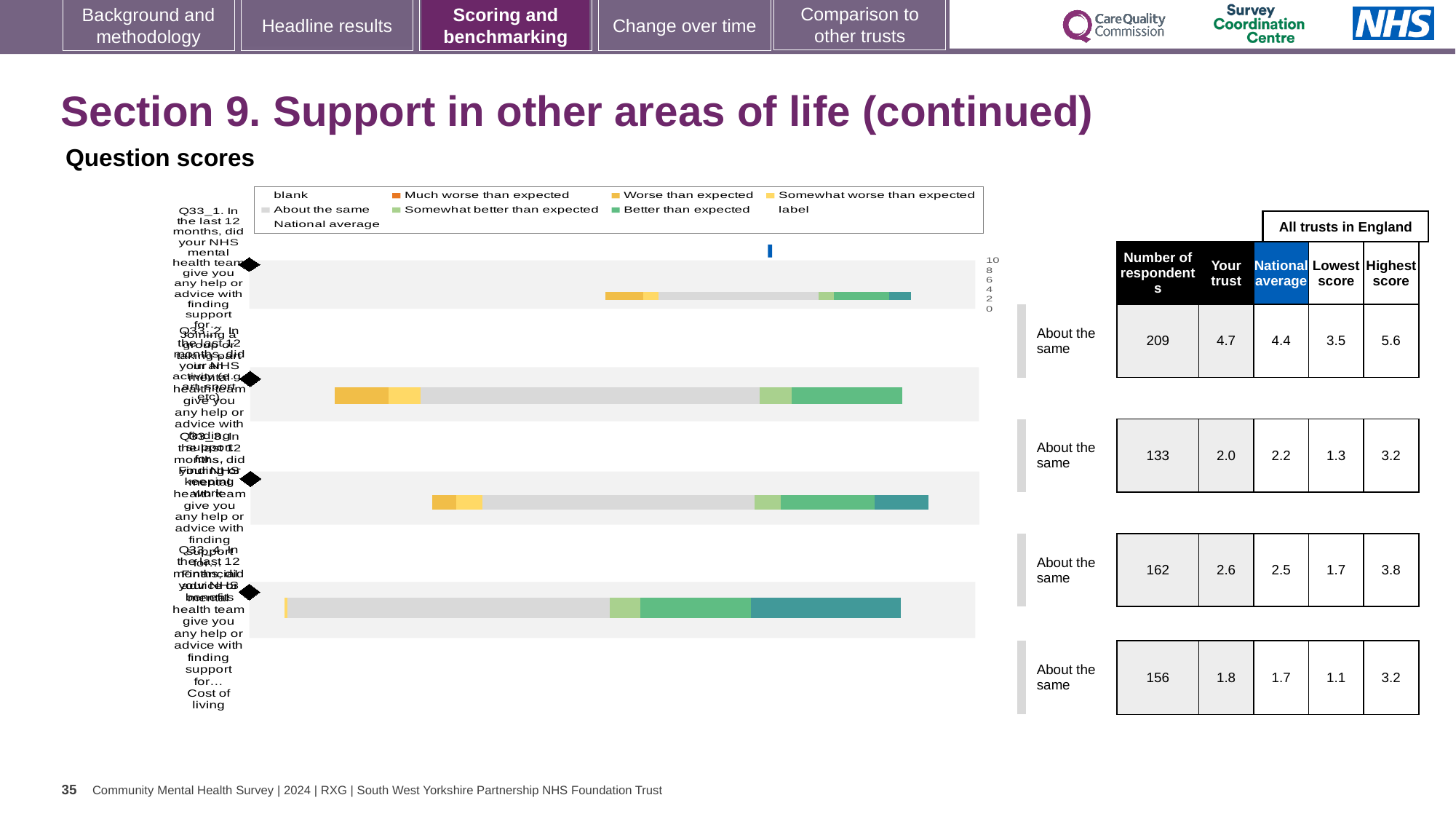
How many entries does the chart legend list? 9 What is the last category label at the bottom of the chart? Cost of living Which legend entry is shown in light grey? About the same Which legend entry is shown in dark orange? Much worse than expected How many question bars are plotted in the chart? 4 What kind of chart is shown under 'Question scores'? bar chart What is the heading printed above the chart? Question scores